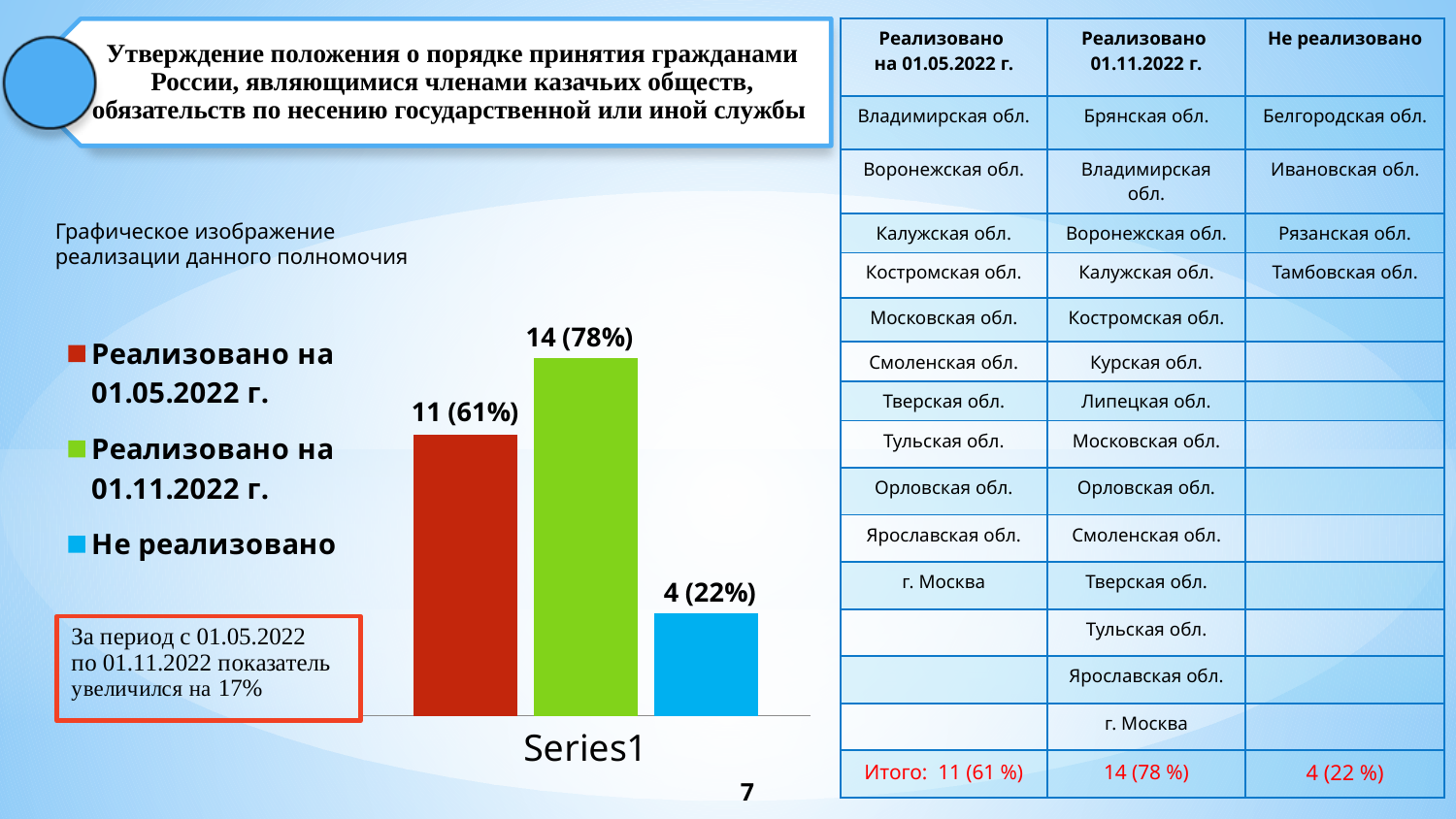
What is the difference in count between the "Реализовано на 01.11.2022 г." bar and the "Реализовано на 01.05.2022 г." bar? 3 What is the data label on the bar for "Реализовано на 01.05.2022 г."? 11 (61%) What type of chart is shown on the slide? Bar chart What colour is the bar for "Не реализовано"? Blue What is the data label on the bar for "Не реализовано"? 4 (22%) How many series does the chart legend list? 3 What label appears under the bars on the x axis of the chart? Series1 How many bars are plotted in the chart? 3 Which is larger: the value for "Реализовано на 01.05.2022 г." or the value for "Не реализовано"? Реализовано на 01.05.2022 г. Which series has the tallest bar in the chart? Реализовано на 01.11.2022 г. Which series has the shortest bar in the chart? Не реализовано What is the data label on the bar for "Реализовано на 01.11.2022 г."? 14 (78%)